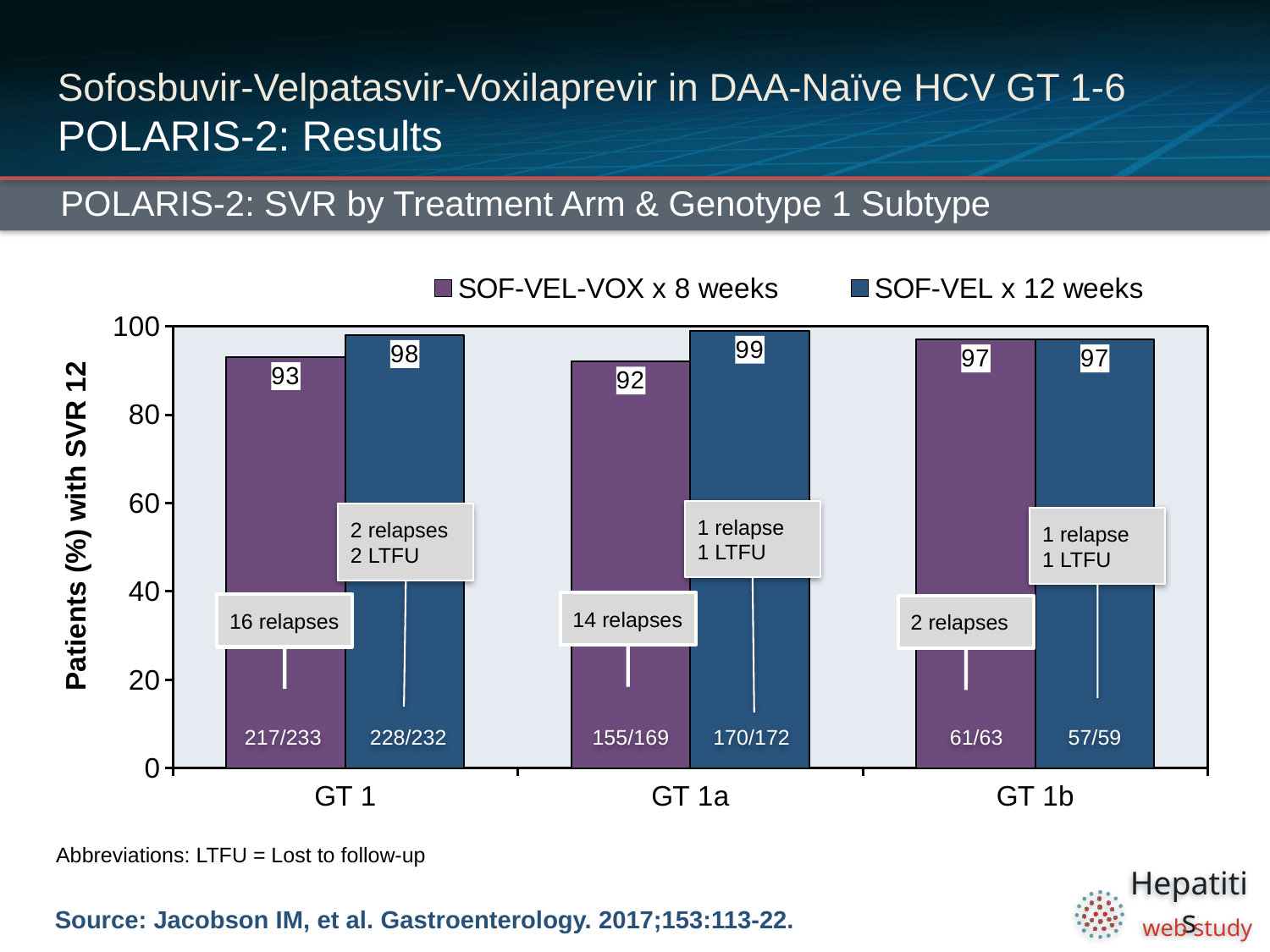
What is the SVR 12 rate for SOF-VEL-VOX x 8 weeks in GT 1? 93 How many genotype categories are shown on the x axis? 3 What is the SVR 12 rate for SOF-VEL x 12 weeks in GT 1a? 99 How many patients achieved SVR 12 out of the total in the SOF-VEL x 12 weeks arm for GT 1? 228/232 Which arm has the higher SVR 12 rate in GT 1, SOF-VEL-VOX x 8 weeks or SOF-VEL x 12 weeks? SOF-VEL x 12 weeks Which genotype category has the lowest SVR 12 rate for SOF-VEL-VOX x 8 weeks? GT 1a How many relapses occurred in the SOF-VEL-VOX x 8 weeks arm for GT 1a? 14 relapses What kind of chart is shown on the slide? Bar chart What is the SVR 12 rate for SOF-VEL-VOX x 8 weeks in GT 1b? 97 What is the difference in SVR 12 rate between SOF-VEL x 12 weeks and SOF-VEL-VOX x 8 weeks in GT 1a? 7 How many series does the legend list? 2 Which genotype category has the highest SVR 12 rate for SOF-VEL x 12 weeks? GT 1a